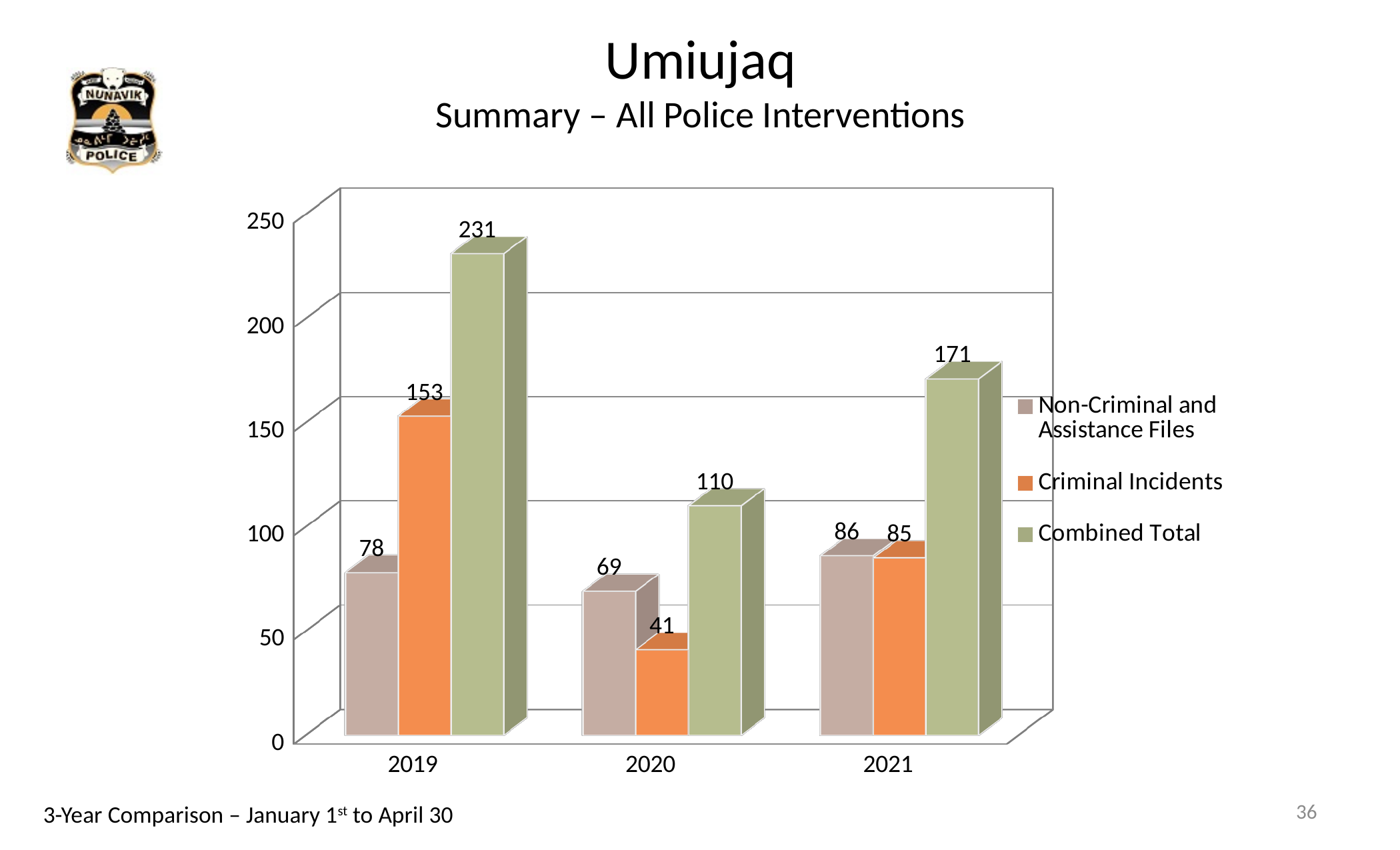
Which year has the highest Combined Total? 2019 What is the Combined Total for 2021? 171 Which is larger: Criminal Incidents in 2019 or Criminal Incidents in 2021? Criminal Incidents in 2019 What is the value for Criminal Incidents in 2019? 153 What is the value for Non-Criminal and Assistance Files in 2020? 69 How many series does the legend list? 3 How many years are shown on the x axis? 3 Is the Combined Total for 2020 greater or less than 100? greater Which series is shown in orange in the legend? Criminal Incidents What is the difference between the Combined Total in 2019 and in 2020? 121 Which year has the lowest value for Criminal Incidents? 2020 What kind of chart is shown on the slide? Bar chart